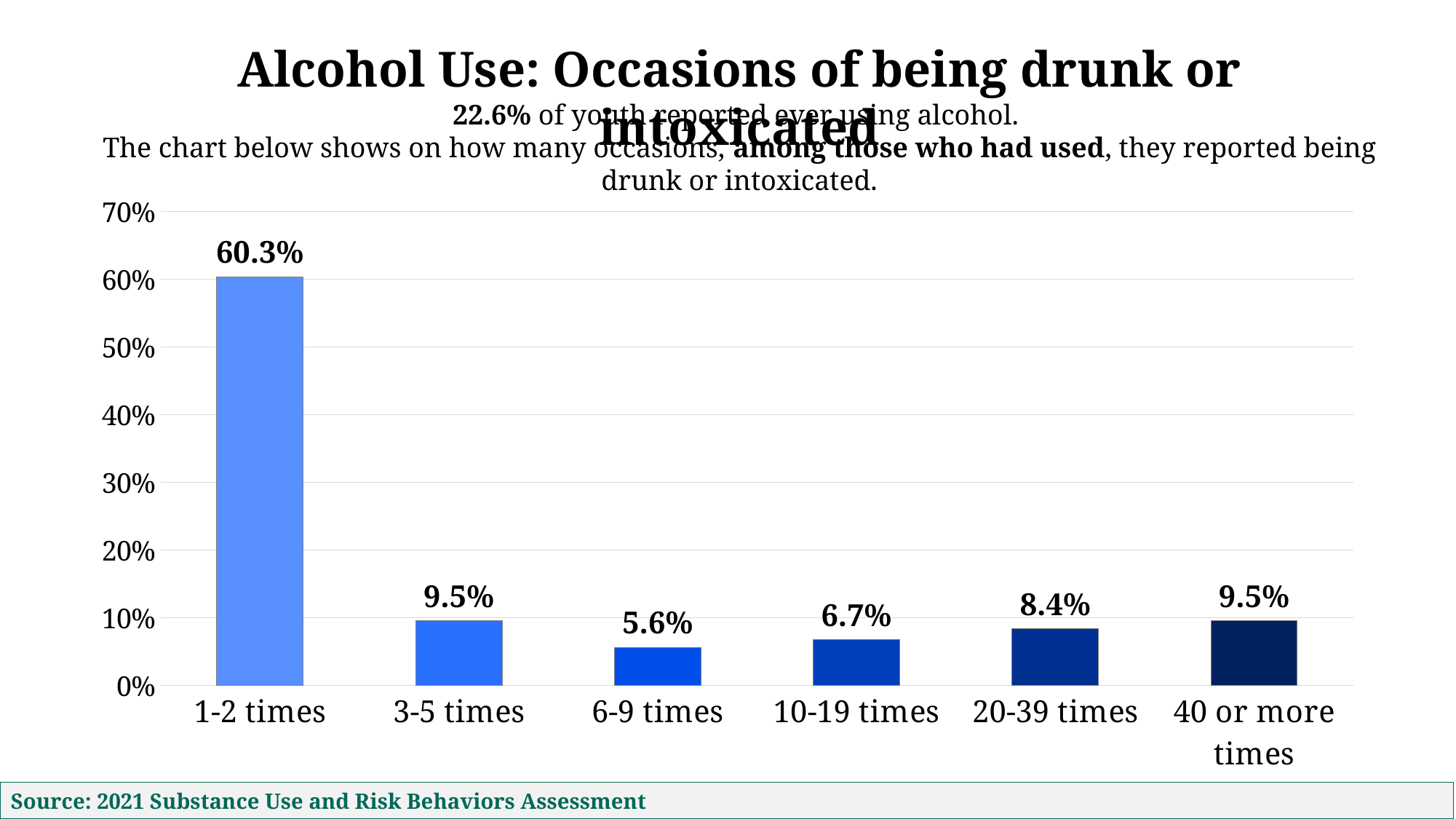
What is the difference between the values for 20-39 times and 6-9 times? 2.8% What is the difference between the values for 1-2 times and 3-5 times? 50.8% What kind of chart is shown on the slide? bar chart How many categories are shown on the x axis? 6 What percentage is shown for 20-39 times? 8.4% What is the value for the 6-9 times category? 5.6% Which category has the lowest value? 6-9 times What percentage is shown for the 1-2 times category? 60.3% What percentage of youth reported ever using alcohol, according to the text above the chart? 22.6% What is the value for the 10-19 times category? 6.7% Which category has the highest value? 1-2 times Which is larger, the value for 10-19 times or the value for 20-39 times? 20-39 times